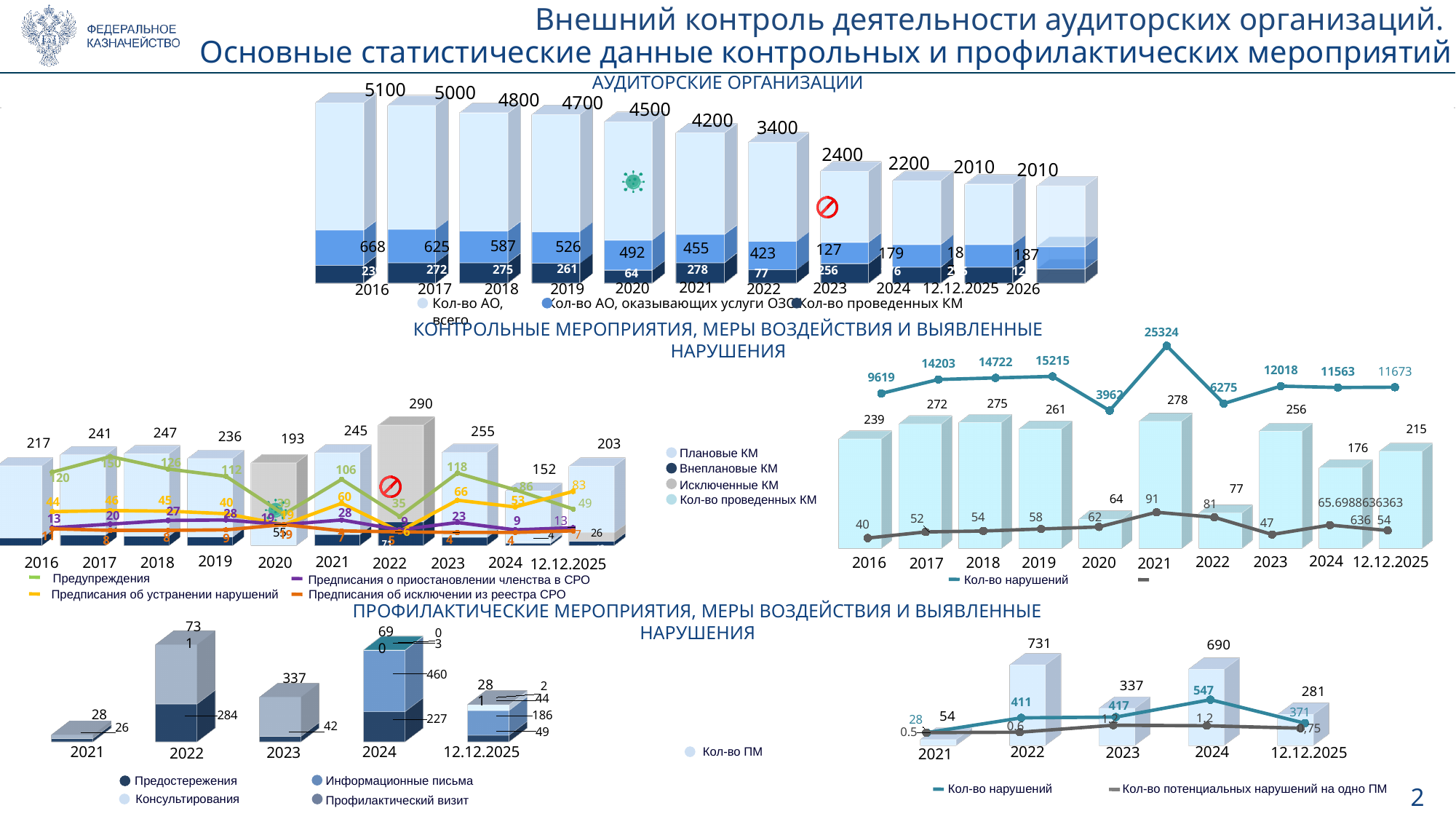
In the middle-right chart (Кол-во нарушений), which year has the lowest value of 'Кол-во нарушений'? 2020 In the middle-right chart (Кол-во нарушений), what is the value of 'Кол-во нарушений' for 2021? 25324 In the top chart 'АУДИТОРСКИЕ ОРГАНИЗАЦИИ', what is the difference between 'Кол-во АО, всего' in 2022 and in 2023? 1000 In the top chart 'АУДИТОРСКИЕ ОРГАНИЗАЦИИ', what is the value of 'Кол-во АО, всего' for 2016? 5100 In the bottom-right chart (Кол-во ПМ), which is larger: 'Кол-во нарушений' in 2024 or in 12.12.2025? 2024 In the top chart 'АУДИТОРСКИЕ ОРГАНИЗАЦИИ', what is the value of 'Кол-во АО, оказывающих услуги ОЗО' for 2020? 492 In the top chart 'АУДИТОРСКИЕ ОРГАНИЗАЦИИ', how many series does the legend list? 3 In the top chart 'АУДИТОРСКИЕ ОРГАНИЗАЦИИ', which year has the highest value of 'Кол-во АО, всего'? 2016 In the top chart 'АУДИТОРСКИЕ ОРГАНИЗАЦИИ', does 'Кол-во АО, всего' rise or fall from 2016 to 2026? fall In the middle-left chart 'КОНТРОЛЬНЫЕ МЕРОПРИЯТИЯ', which year has the highest bar total? 2022 In the bottom-left chart 'ПРОФИЛАКТИЧЕСКИЕ МЕРОПРИЯТИЯ', how many years are shown on the x axis? 5 In the bottom-right chart (Кол-во ПМ), what is the value of 'Кол-во ПМ' for 2022? 731